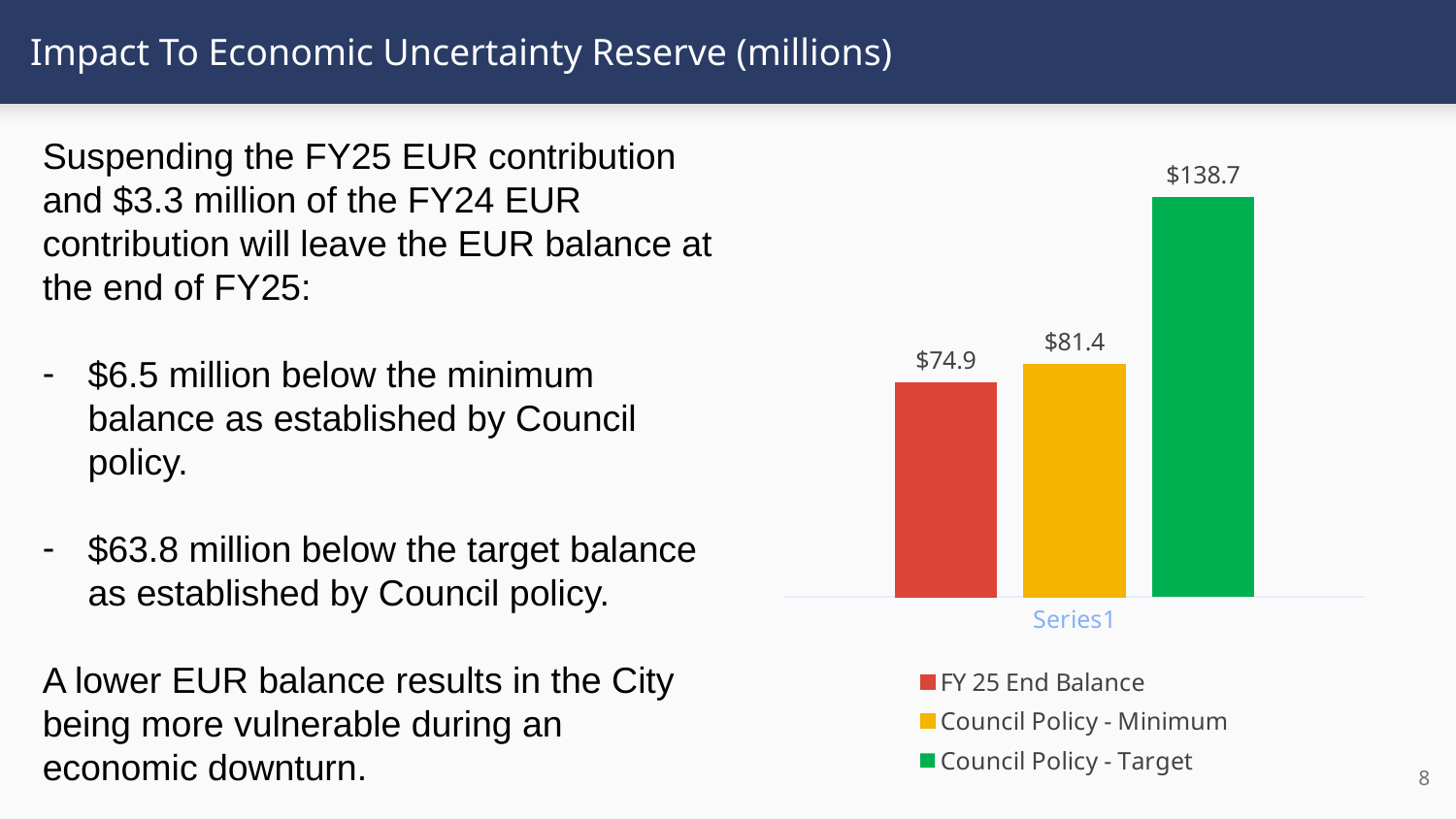
What is the value for Council Policy - Minimum? $81.4 What is the value for Council Policy - Target? $138.7 How many series does the legend list? 3 What is the category label shown on the x axis? Series1 What is the difference between Council Policy - Minimum and FY 25 End Balance? $6.5 Which series has the lowest value? FY 25 End Balance What kind of chart is shown on the slide? bar chart Which is larger, Council Policy - Minimum or Council Policy - Target? Council Policy - Target What is the value for FY 25 End Balance? $74.9 What colour is the bar for Council Policy - Target? green Which series has the highest value? Council Policy - Target What is the difference between Council Policy - Target and FY 25 End Balance? $63.8